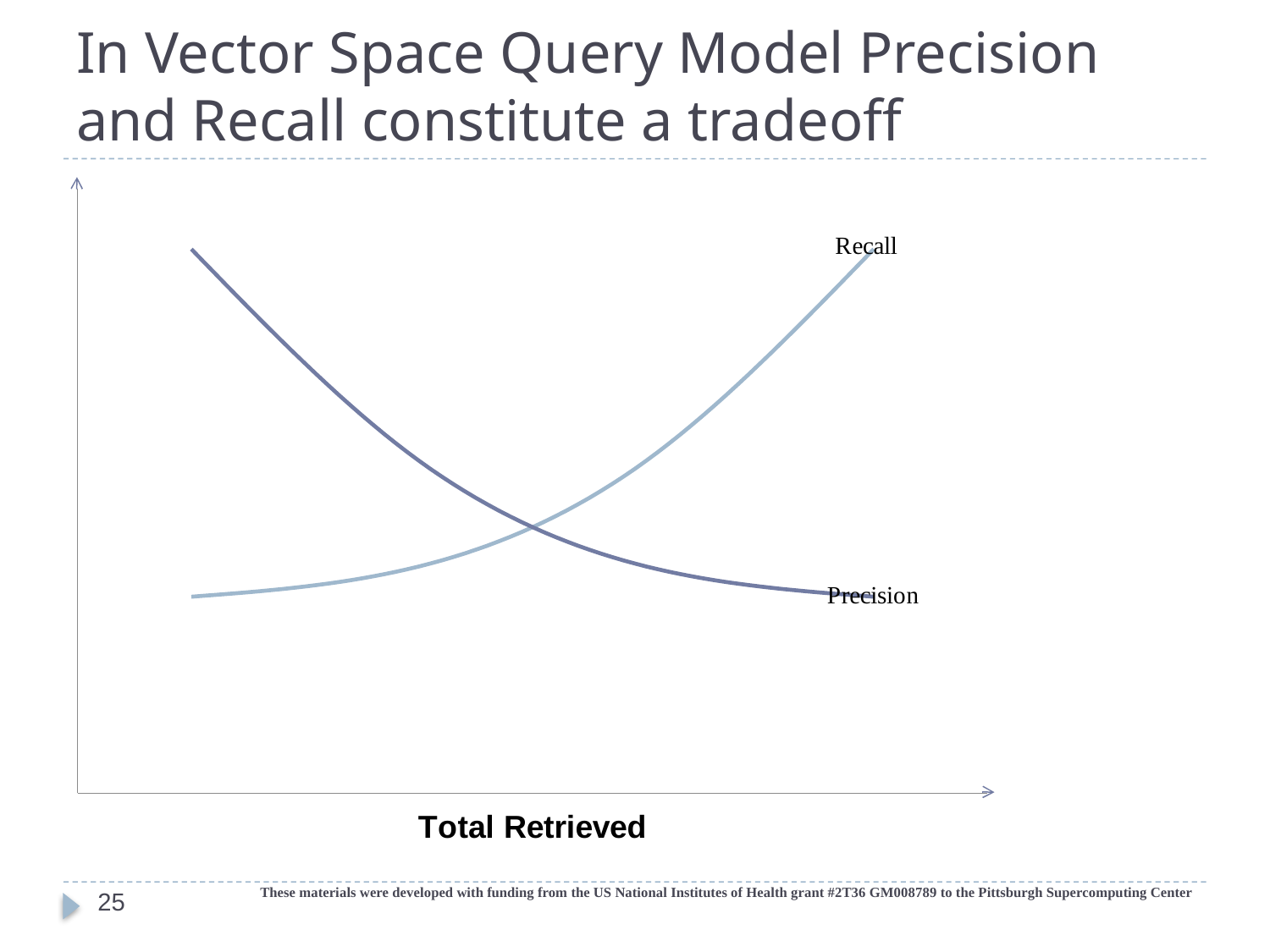
Does the Recall curve rise or fall as Total Retrieved increases? rises Which curve is labelled at the top right of the chart? Recall What is the label of the x axis? Total Retrieved At the right end of the chart, which curve is higher, Recall or Precision? Recall How many lines are plotted on the chart? 2 What kind of chart is shown on the slide? line chart Does the Precision curve rise or fall as Total Retrieved increases? falls Do the Recall and Precision curves cross each other on the chart? yes At the left end of the chart, which curve is higher, Recall or Precision? Precision